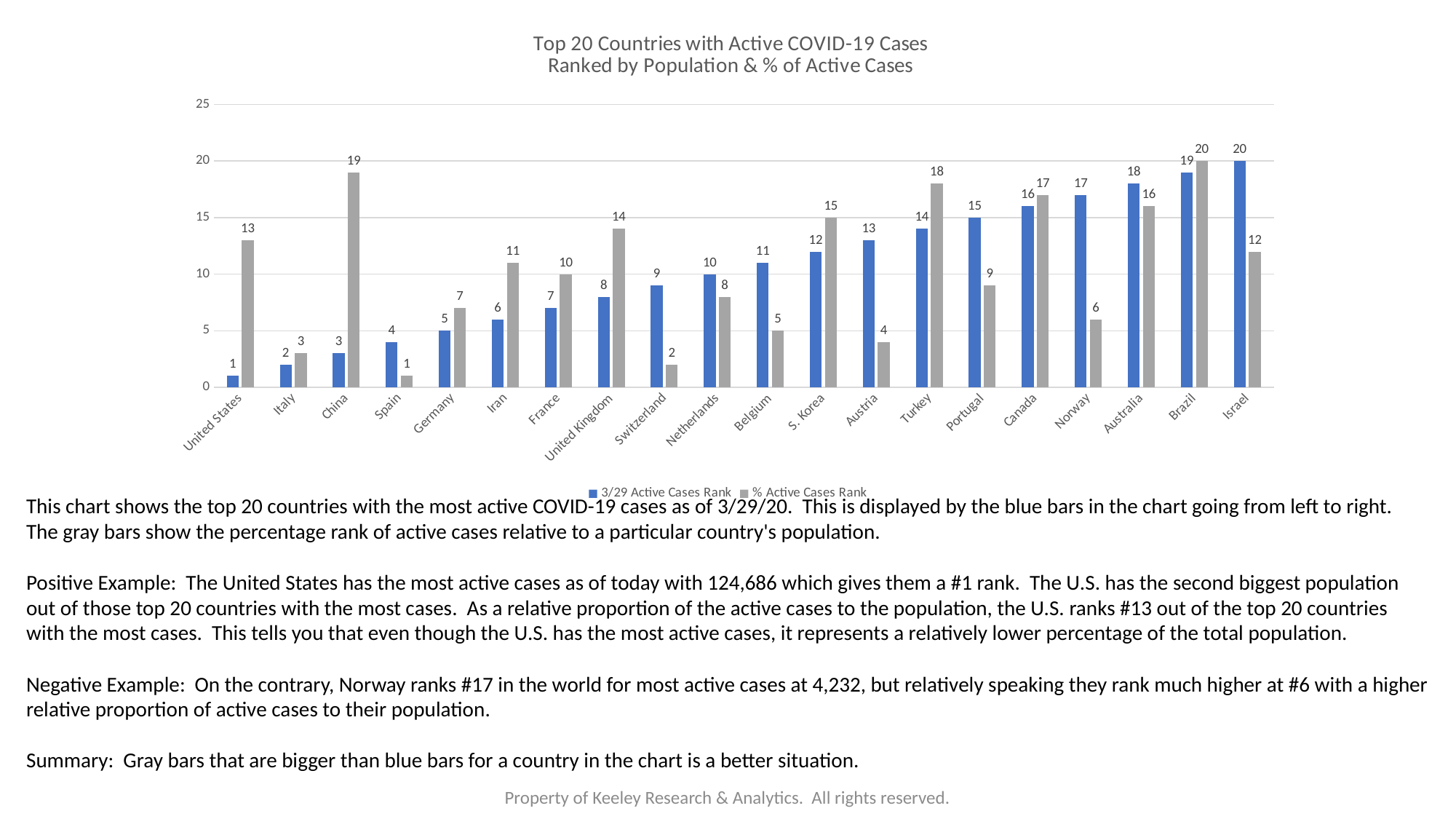
For Israel, which is larger: the 3/29 Active Cases Rank or the % Active Cases Rank? 3/29 Active Cases Rank What is the 3/29 Active Cases Rank value for Norway? 17 How many series does the legend list? 2 Which country has the lowest % Active Cases Rank value? Spain Which country has the highest % Active Cases Rank value? Brazil What is the % Active Cases Rank value for the United States? 13 What is the % Active Cases Rank value for China? 19 How many countries are shown on the x axis? 20 What kind of chart is shown on the slide? Bar chart What is the difference between the % Active Cases Rank and the 3/29 Active Cases Rank for Norway? 11 Do the blue 3/29 Active Cases Rank values rise or fall from left to right along the x axis? Rise Is the % Active Cases Rank value for Turkey greater or less than 15? greater